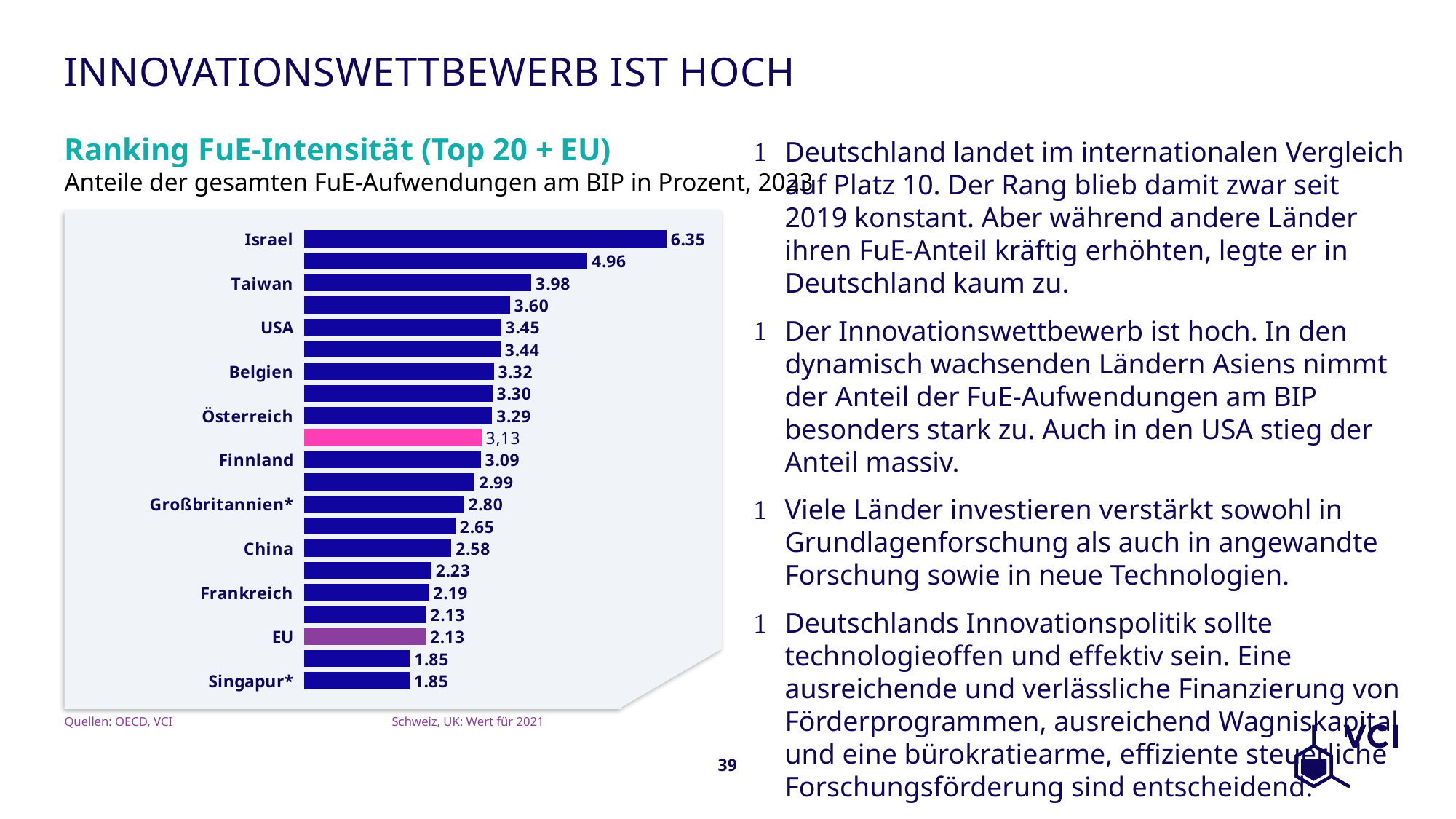
What is the value for EU? 2.13 What is the value for USA? 3.45 Which category has the highest value? Israel What is the difference between the values for USA and China? 0.87 What kind of chart is shown on the slide? bar chart How many bars are plotted in the chart? 21 What is the value for Taiwan? 3.98 What is the value for Singapur*? 1.85 Which is larger, the value for Belgien or the value for Finnland? Belgien What is the value for Israel? 6.35 What is the difference between the values for Israel and Taiwan? 2.37 What is the value for China? 2.58